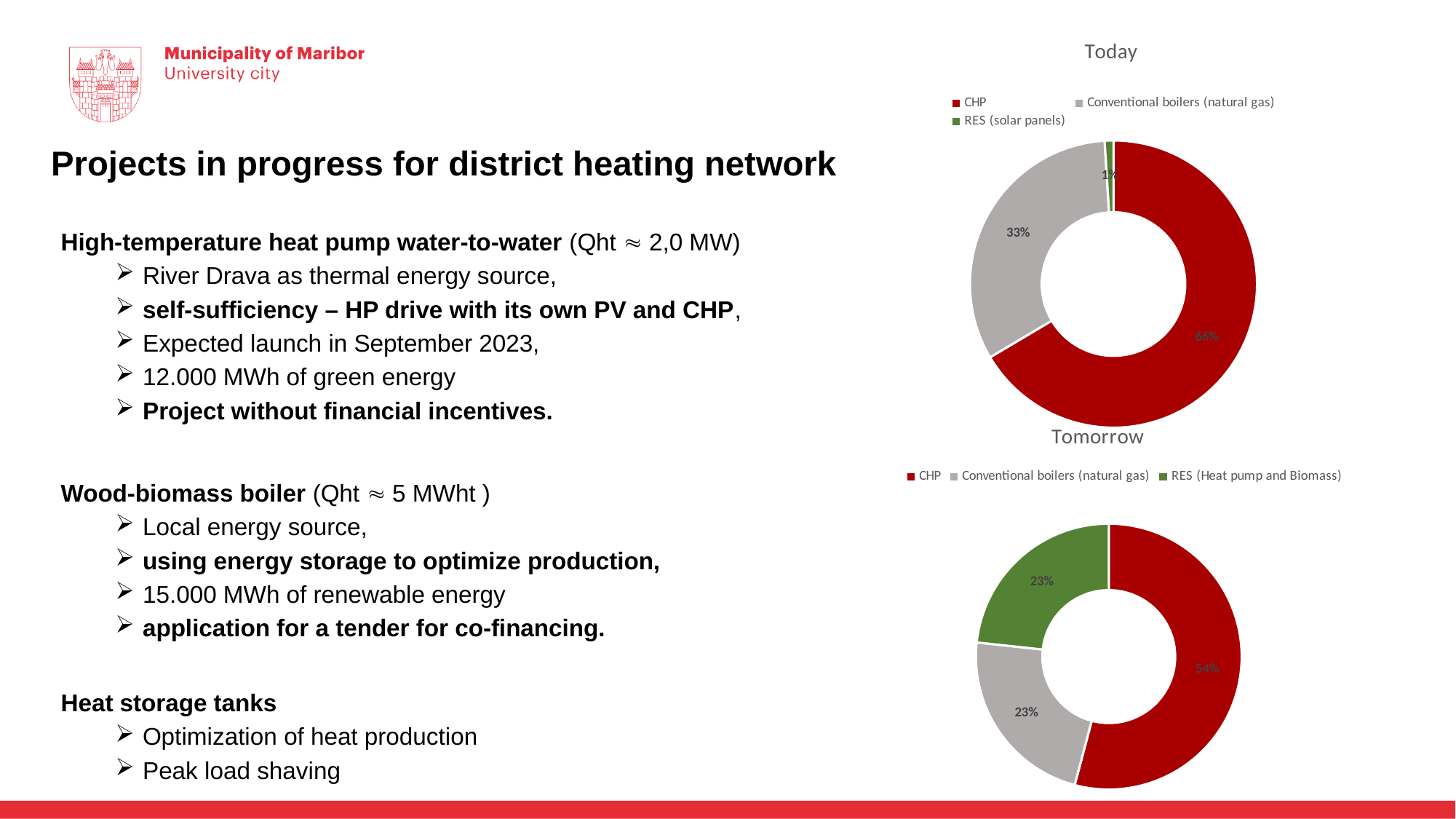
In the "Tomorrow" chart, which colour represents RES (Heat pump and Biomass)? Green In the "Today" chart, which category has the largest share? CHP In the "Today" chart, how many categories are shown in the legend? 3 In the "Today" chart, what share does RES (solar panels) have? 1% In the "Tomorrow" chart, which category has the largest share? CHP In the "Today" chart, what share does CHP have? 66% In the "Tomorrow" chart, what share does RES (Heat pump and Biomass) have? 23% What is the difference between the CHP share in the "Today" chart and the CHP share in the "Tomorrow" chart? 12% In the "Tomorrow" chart, what share does CHP have? 54% In the "Today" chart, what share do conventional boilers (natural gas) have? 33% In the "Today" chart, which category has the smallest share? RES (solar panels) What type of chart is the "Tomorrow" chart? Doughnut chart